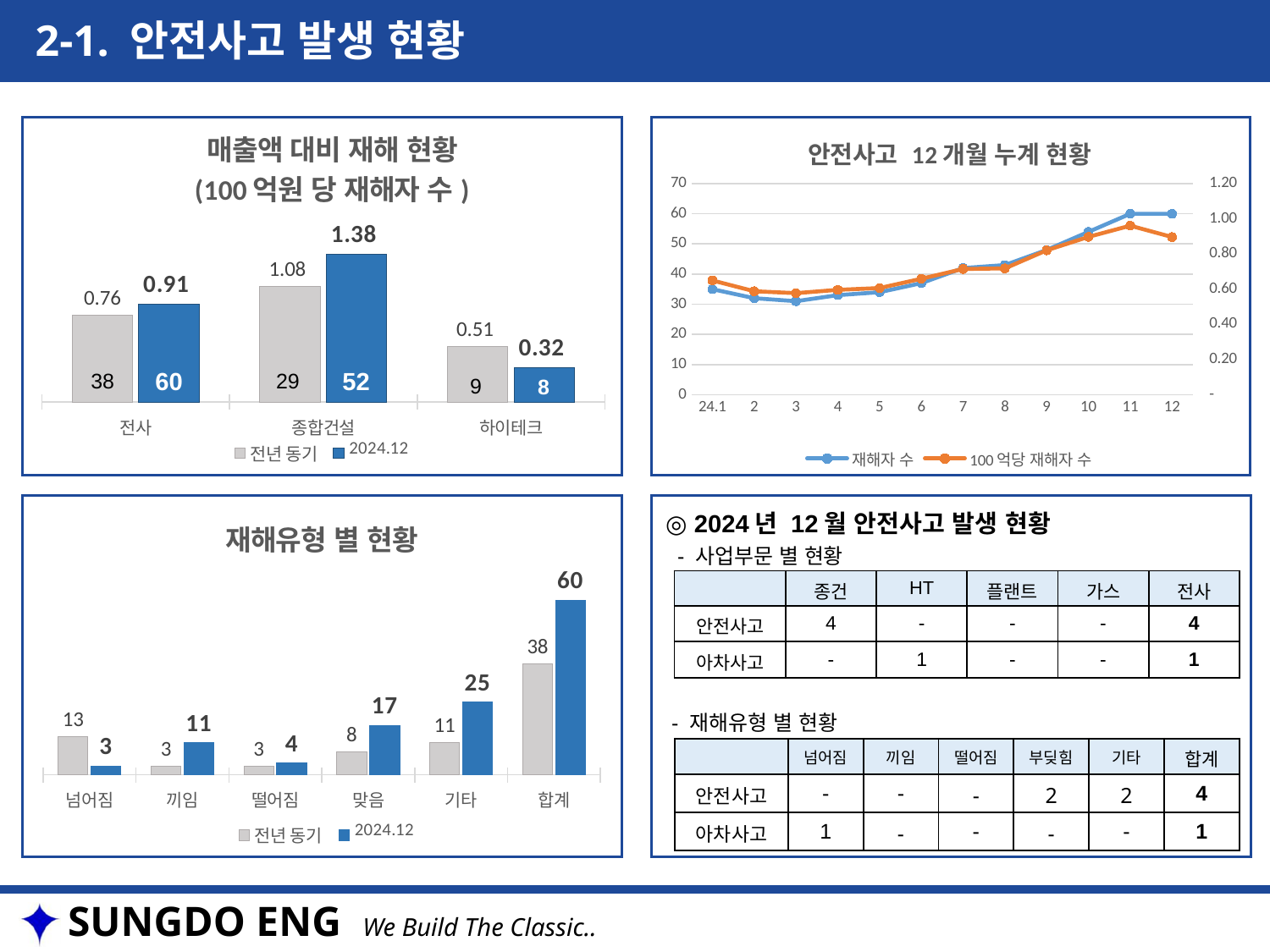
In the chart titled 안전사고 12개월 누계 현황, what kind of chart is it? line chart In the chart titled 재해유형 별 현황, what is the difference between the 2024.12 and 전년 동기 values for 합계? 22 In the chart titled 안전사고 12개월 누계 현황, is the 재해자 수 value at 3 greater or less than 40? less In the chart titled 매출액 대비 재해 현황, what is the 전년 동기 value for 하이테크? 0.51 In the chart titled 매출액 대비 재해 현황, which category has the highest 2024.12 value? 종합건설 In the chart titled 재해유형 별 현황, what is the 2024.12 value for 기타? 25 In the chart titled 재해유형 별 현황, how many categories are shown on the x axis? 6 In the chart titled 재해유형 별 현황, what is the 전년 동기 value for 넘어짐? 13 In the chart titled 매출액 대비 재해 현황, what is the difference between the 2024.12 and 전년 동기 values for 전사? 0.15 In the chart titled 매출액 대비 재해 현황, what is the 2024.12 value for 종합건설? 1.38 In the chart titled 재해유형 별 현황, which is larger for 맞음: the 전년 동기 value or the 2024.12 value? 2024.12 In the chart titled 매출액 대비 재해 현황, how many series does the legend list? 2